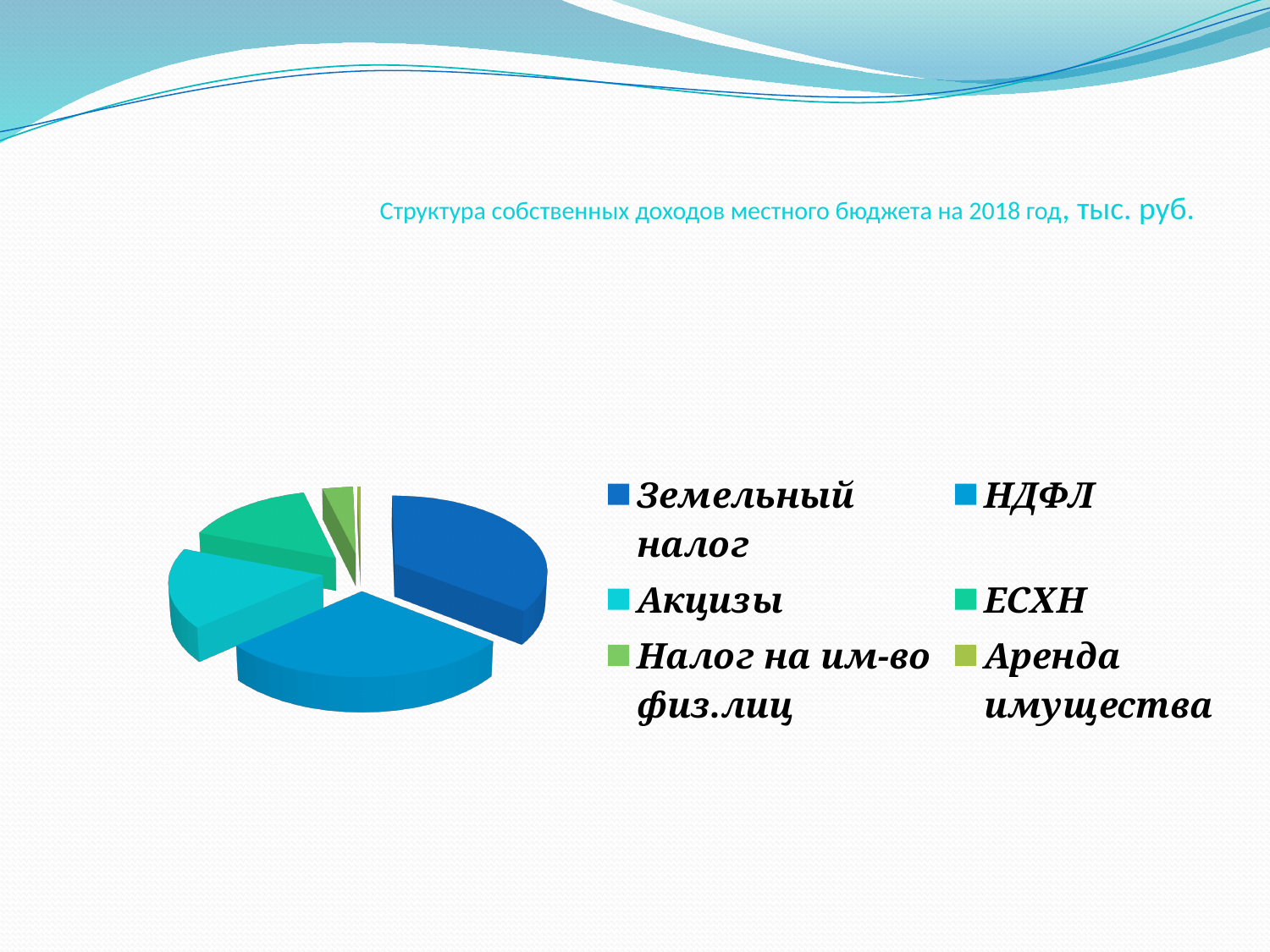
Which category has the largest slice in the pie chart? Земельный налог What kind of chart is shown on the slide? pie chart In what unit are the values of the chart expressed, according to its title? тыс. руб. Which slice is larger: Земельный налог or ЕСХН? Земельный налог Which slice is larger: Акцизы or Аренда имущества? Акцизы Which slice is larger: Налог на им-во физ.лиц or Акцизы? Акцизы How many categories does the legend of the pie chart list? 6 What is the title of the chart on the slide? Структура собственных доходов местного бюджета на 2018 год, тыс. руб. Which category has the smallest slice in the pie chart? Аренда имущества